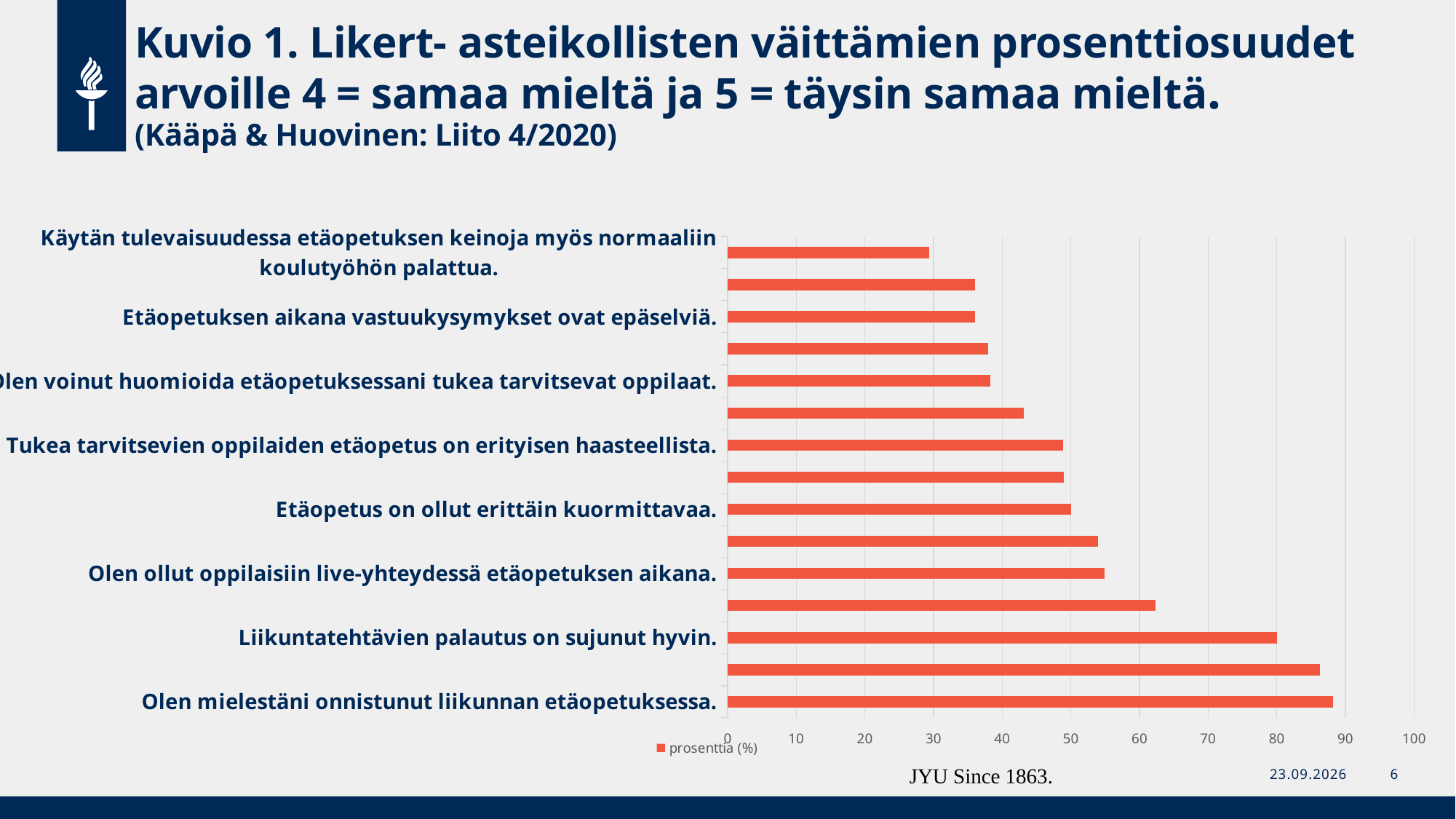
Is the value for "Etäopetuksen aikana vastuukysymykset ovat epäselviä." greater or less than 40? less What is the name of the series shown in the legend? prosenttia (%) Is the value for "Olen mielestäni onnistunut liikunnan etäopetuksessa." greater or less than 80? greater Which is larger: the value for "Liikuntatehtävien palautus on sujunut hyvin." or for "Etäopetus on ollut erittäin kuormittavaa."? Liikuntatehtävien palautus on sujunut hyvin. What is the maximum value shown on the horizontal axis? 100 How many series does the legend list? 1 Is the value for "Olen ollut oppilaisiin live-yhteydessä etäopetuksen aikana." greater or less than 50? greater Which labelled statement has the lowest percentage? Käytän tulevaisuudessa etäopetuksen keinoja myös normaaliin koulutyöhön palattua. What kind of chart is shown on the slide? bar chart Which labelled statement has the highest percentage? Olen mielestäni onnistunut liikunnan etäopetuksessa.